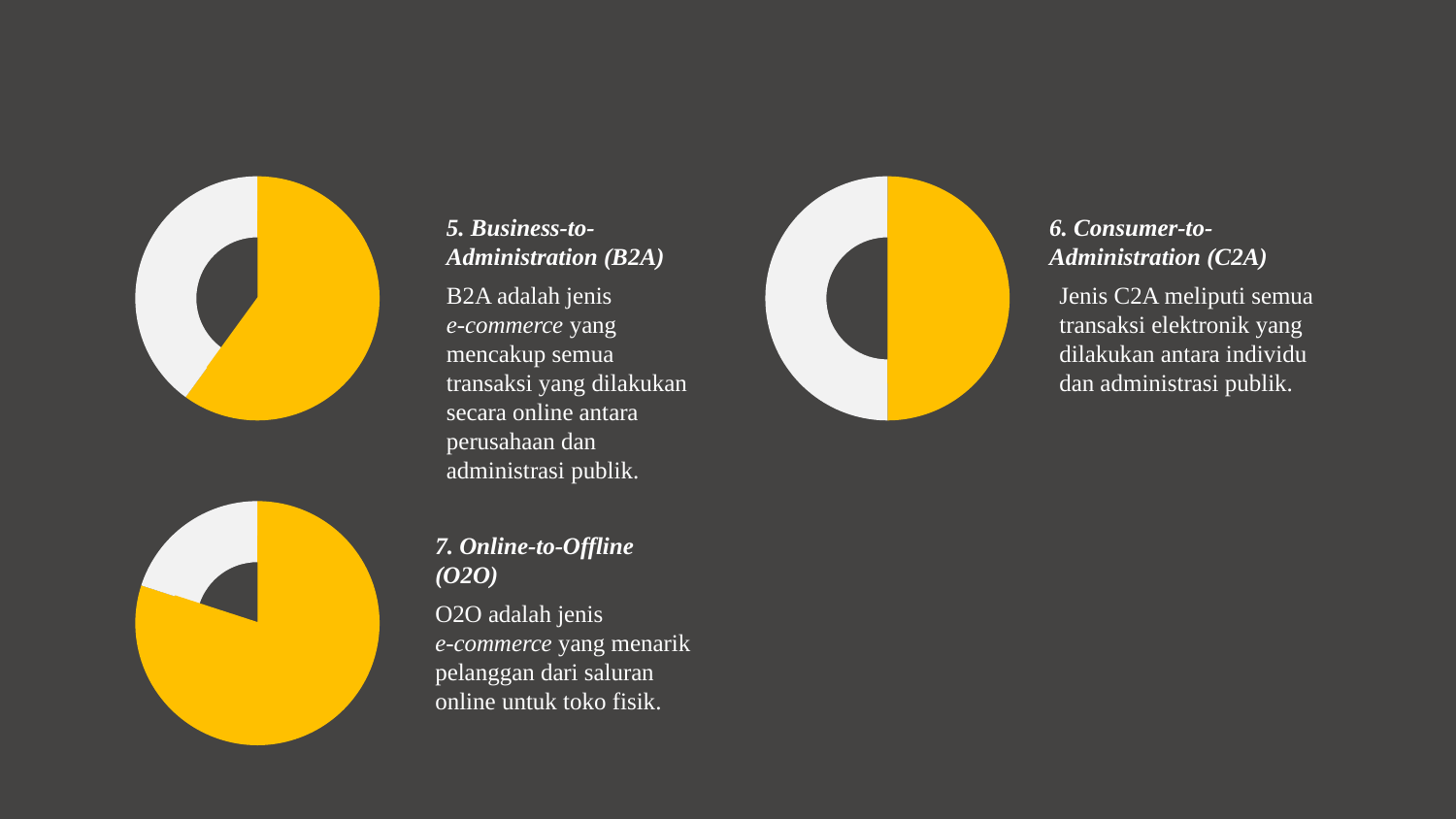
How many slices does the top-right pie chart (next to item 6, C2A) have? 2 What kind of chart is shown at the top left of the slide, next to item 5 (B2A)? doughnut chart What kind of chart is shown at the top right of the slide, next to item 6 (C2A)? doughnut chart How many pie charts are shown on the slide? 3 In the top-left pie chart (next to item 5, B2A), which slice is larger, the yellow one or the white one? yellow How many slices does the top-left pie chart (next to item 5, B2A) have? 2 In the bottom-left pie chart (next to item 7, O2O), which slice is larger, the yellow one or the white one? yellow Does the top-right pie chart (next to item 6, C2A) show a legend? No What two colours are used for the slices in the pie charts on the slide? yellow and white What kind of chart is shown at the bottom left of the slide, next to item 7 (O2O)? doughnut chart